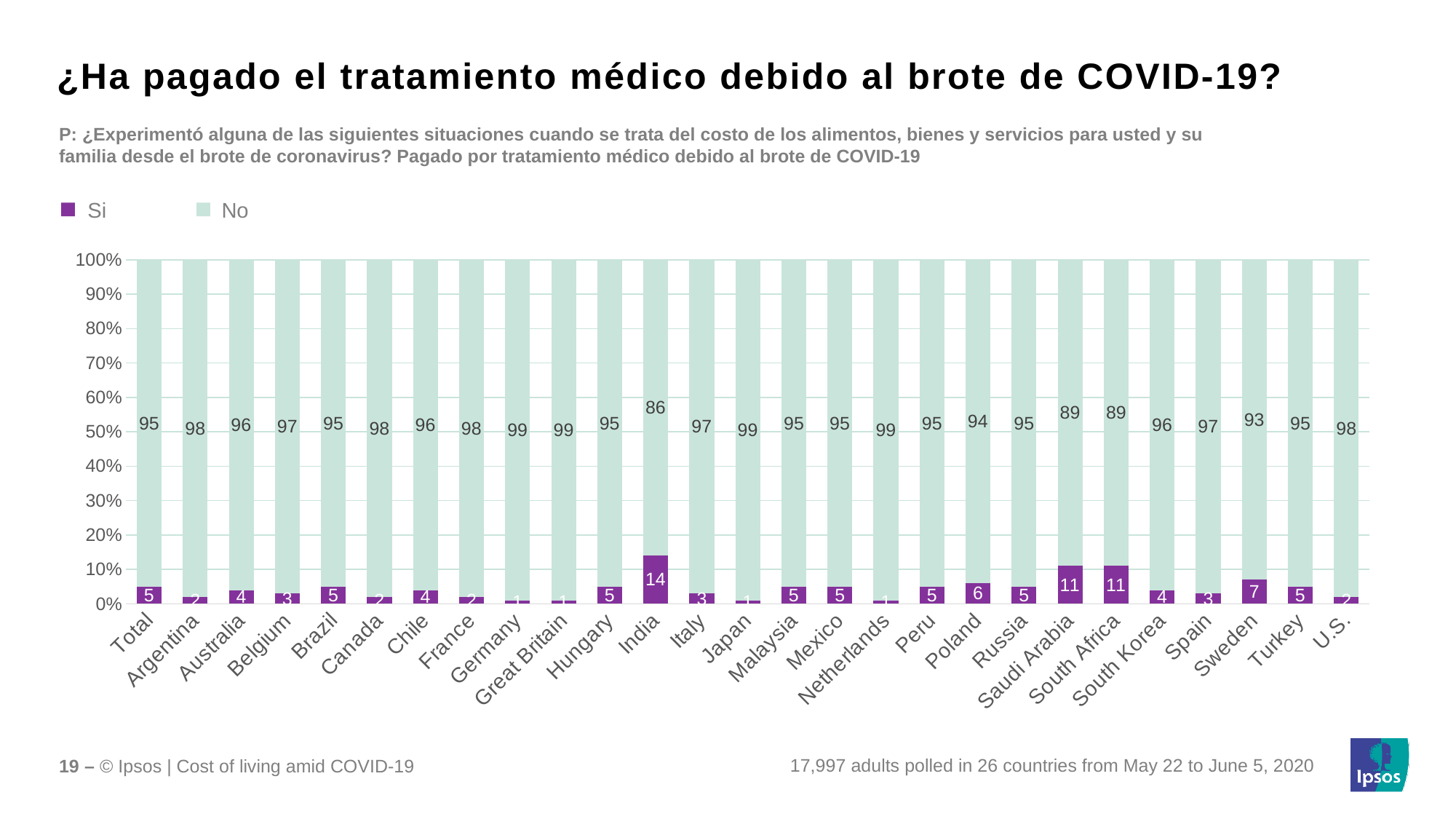
What is the difference between the Si value for India and the Si value for Total? 9 Which country has the lowest No value? India How many categories are shown on the x axis? 27 What is the total of the stacked bar for India (Si plus No)? 100 What kind of chart is shown on the slide? Stacked bar chart What is the Si value for Sweden? 7 What are the two legend entries of the chart? Si and No How many series does the legend list? 2 What is the value of the Si series for India? 14 Which country has the highest Si value? India Which has a larger Si value, Poland or Russia? Poland What is the value of the No series for Saudi Arabia? 89